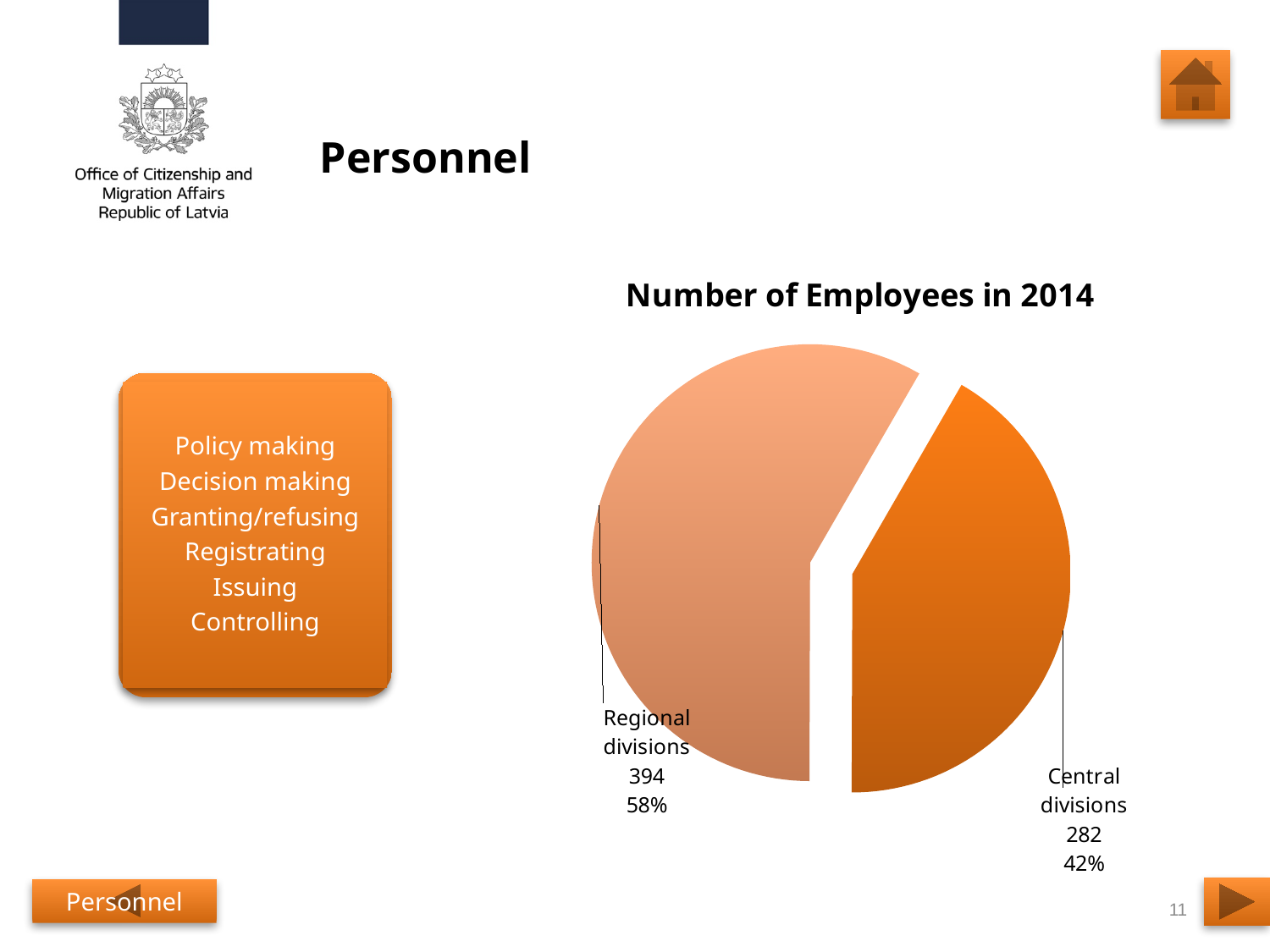
What kind of chart is shown on the slide? Pie chart Are there more employees in Central divisions or in Regional divisions? Regional divisions How many more employees are in Regional divisions than in Central divisions? 112 Which division group has the smaller number of employees? Central divisions What is the title of the chart? Number of Employees in 2014 What share of employees do Central divisions account for? 42% What is the total number of employees across both division groups? 676 What is the number of employees in Central divisions? 282 What share of employees do Regional divisions account for? 58% How many slices does the pie chart have? 2 What is the number of employees in Regional divisions? 394 Which division group has the larger number of employees? Regional divisions